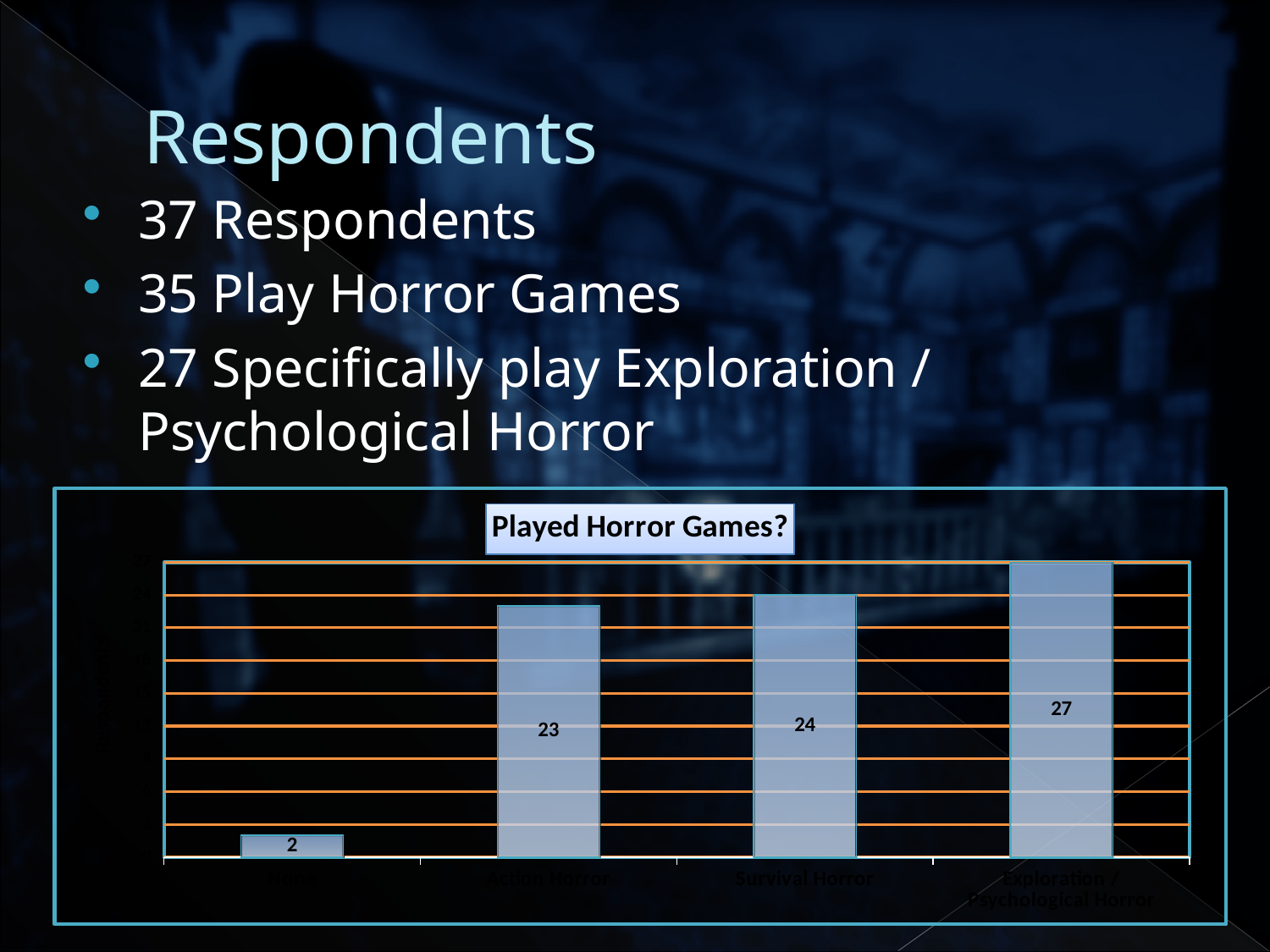
What is the value for None in the Played Horror Games? chart? 2 What is the value for Action Horror in the Played Horror Games? chart? 23 What is the title of the chart on the slide? Played Horror Games? What is the value for Survival Horror in the Played Horror Games? chart? 24 In the Played Horror Games? chart, which is larger: the value for Action Horror or the value for Exploration / Psychological Horror? Exploration / Psychological Horror How many categories are shown in the Played Horror Games? chart? 4 What is the difference between the values for Survival Horror and None in the Played Horror Games? chart? 22 What kind of chart is the Played Horror Games? chart? bar chart What is the value for Exploration / Psychological Horror in the Played Horror Games? chart? 27 Which category has the lowest value in the Played Horror Games? chart? None Which category has the highest value in the Played Horror Games? chart? Exploration / Psychological Horror What is the difference between the values for Exploration / Psychological Horror and Action Horror in the Played Horror Games? chart? 4